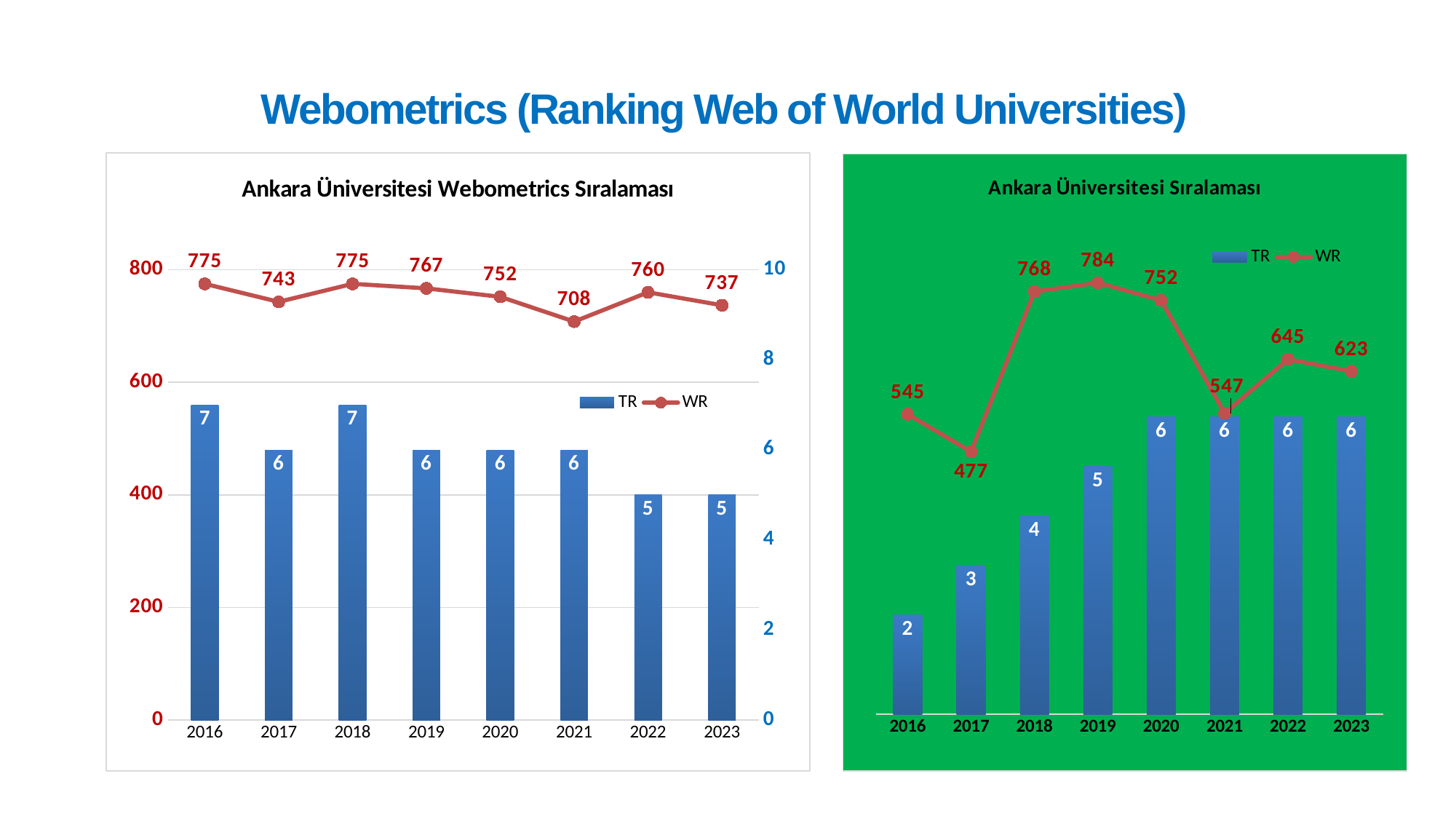
In the right chart (Ankara Üniversitesi Sıralaması, green background), what is the WR value for 2017? 477 In the left chart (Ankara Üniversitesi Webometrics Sıralaması), what is the TR value for 2016? 7 In the left chart (Ankara Üniversitesi Webometrics Sıralaması), what is the WR value for 2021? 708 In the right chart (Ankara Üniversitesi Sıralaması, green background), which year has the highest WR value? 2019 In the left chart (Ankara Üniversitesi Webometrics Sıralaması), what is the difference between the WR values for 2016 and 2023? 38 In the right chart (Ankara Üniversitesi Sıralaması, green background), is the WR value for 2022 or 2023 larger? 2022 In the right chart (Ankara Üniversitesi Sıralaması, green background), what is the TR value for 2018? 4 In the right chart (Ankara Üniversitesi Sıralaması, green background), what is the difference between the WR values for 2019 and 2017? 307 How many series does the legend of the left chart list? 2 In the left chart (Ankara Üniversitesi Webometrics Sıralaması), how many years are shown on the x axis? 8 In the left chart (Ankara Üniversitesi Webometrics Sıralaması), which year has the lowest WR value? 2021 In the right chart (Ankara Üniversitesi Sıralaması, green background), do the TR bar values rise or fall from 2016 to 2020? rise